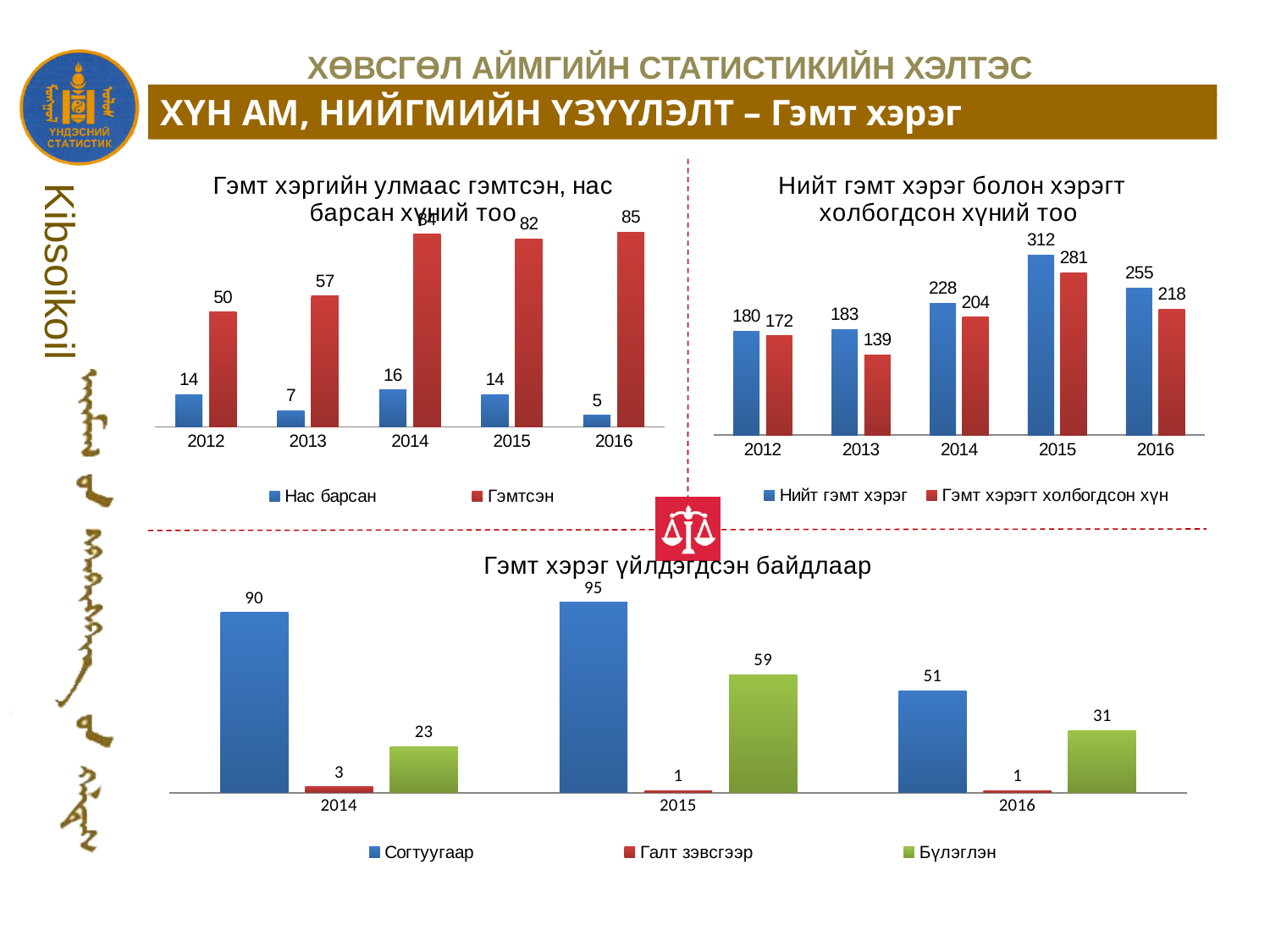
In the top-left chart 'Гэмт хэргийн улмаас гэмтсэн, нас барсан хүний тоо', what is the value of Гэмтсэн for 2013? 57 In the bottom chart 'Гэмт хэрэг үйлдэгдсэн байдлаар', what is the value of Согтуугаар for 2015? 95 What type of chart is the bottom chart 'Гэмт хэрэг үйлдэгдсэн байдлаар'? Bar chart In the bottom chart 'Гэмт хэрэг үйлдэгдсэн байдлаар', which year has the highest value for Бүлэглэн? 2015 In the top-left chart 'Гэмт хэргийн улмаас гэмтсэн, нас барсан хүний тоо', which year has the lowest value for Нас барсан? 2016 In the chart 'Нийт гэмт хэрэг болон хэрэгт холбогдсон хүний тоо', what is the difference between Нийт гэмт хэрэг and Гэмт хэрэгт холбогдсон хүн in 2016? 37 In the chart 'Нийт гэмт хэрэг болон хэрэгт холбогдсон хүний тоо', what is the value of Гэмт хэрэгт холбогдсон хүн for 2013? 139 In the top-left chart 'Гэмт хэргийн улмаас гэмтсэн, нас барсан хүний тоо', what is the value of Нас барсан for 2016? 5 In the chart 'Нийт гэмт хэрэг болон хэрэгт холбогдсон хүний тоо', which year has the highest value for Нийт гэмт хэрэг? 2015 How many series does the legend of the bottom chart 'Гэмт хэрэг үйлдэгдсэн байдлаар' list? 3 In the bottom chart 'Гэмт хэрэг үйлдэгдсэн байдлаар', is the value of Согтуугаар larger in 2014 or in 2016? 2014 In the chart 'Нийт гэмт хэрэг болон хэрэгт холбогдсон хүний тоо', what is the value of Нийт гэмт хэрэг for 2015? 312